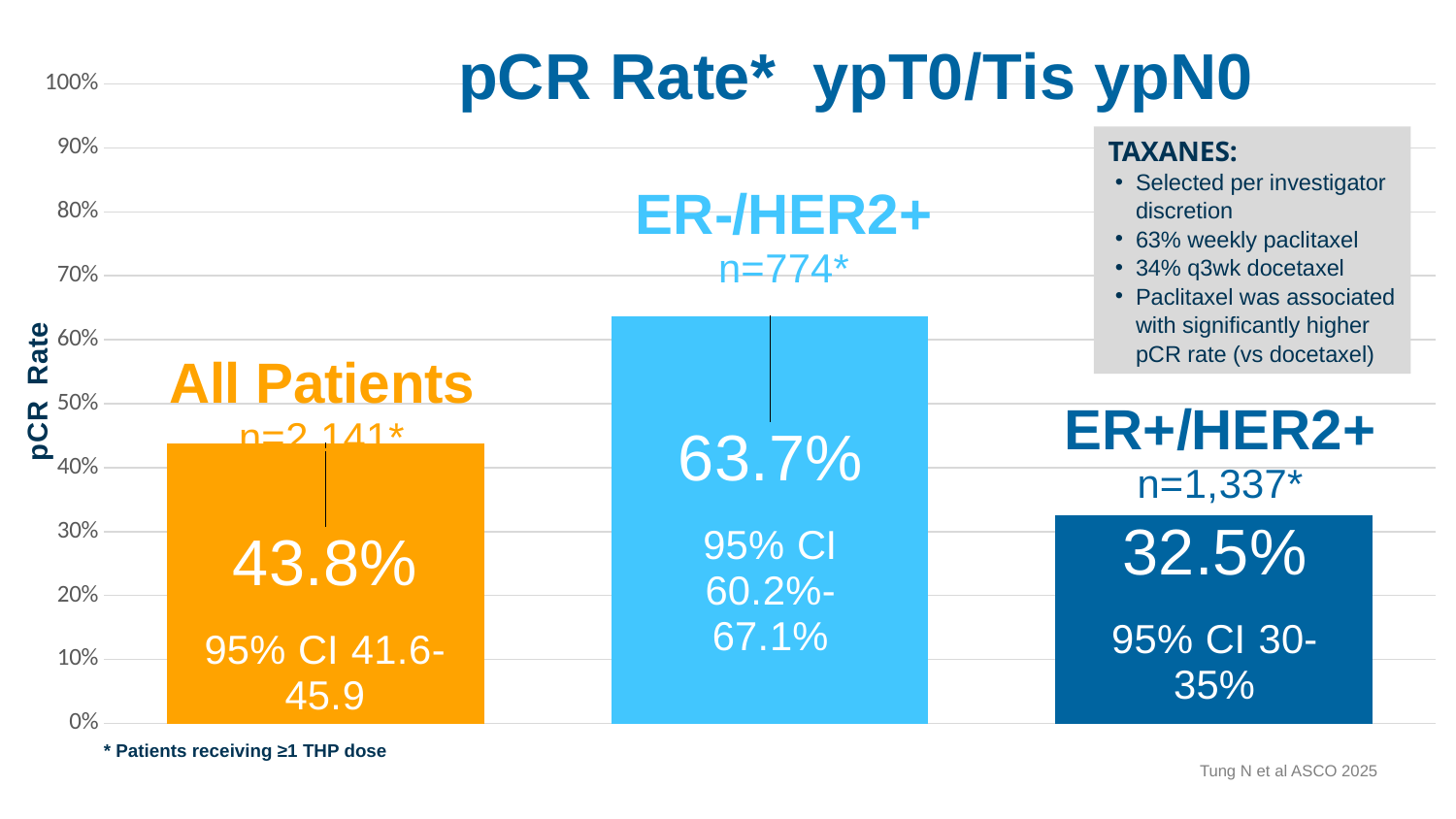
Which has a higher pCR rate, All Patients or ER+/HER2+? All Patients What is the pCR rate for the ER-/HER2+ group? 63.7% How many groups are shown as bars in the chart? 3 Which group has the lowest pCR rate? ER+/HER2+ What kind of chart is shown on the slide? Bar chart What is the title of the chart? pCR Rate* ypT0/Tis ypN0 What is the 95% CI for the pCR rate in the ER-/HER2+ group? 60.2%-67.1% What is the pCR rate for the ER+/HER2+ group? 32.5% What is the difference in pCR rate between the ER-/HER2+ and ER+/HER2+ groups? 31.2% Which group has the highest pCR rate? ER-/HER2+ What is the pCR rate for All Patients? 43.8% Is the pCR rate for ER-/HER2+ greater or less than 60%? greater